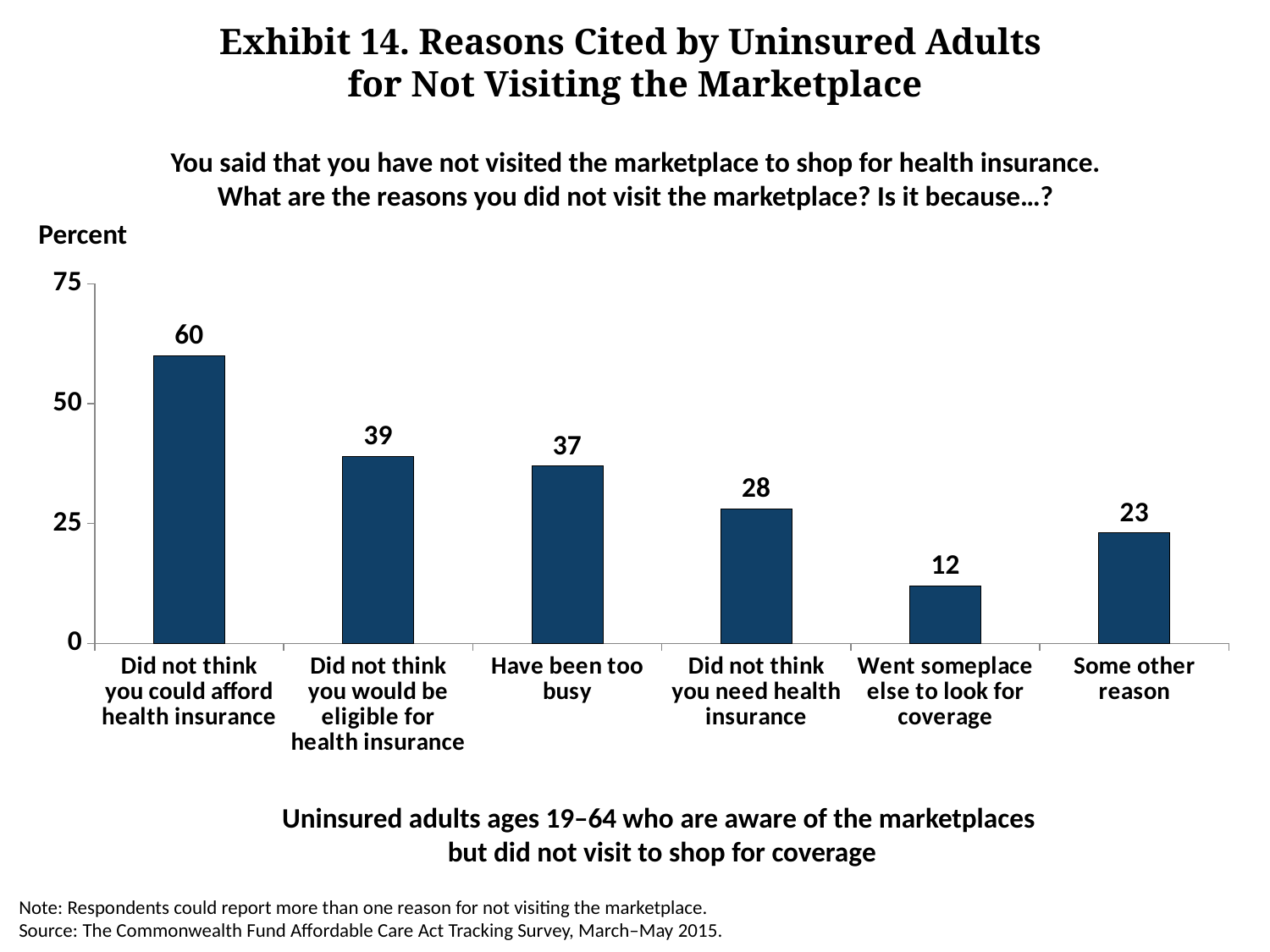
What is the difference between 'Did not think you could afford health insurance' and 'Did not think you would be eligible for health insurance'? 21 Which reason has the highest value? Did not think you could afford health insurance What is the value for 'Have been too busy'? 37 What percent cited 'Went someplace else to look for coverage'? 12 Which is larger: 'Did not think you would be eligible for health insurance' or 'Have been too busy'? Did not think you would be eligible for health insurance What is the value for 'Some other reason'? 23 How many reasons (categories) are shown in the chart? 6 What is the difference between 'Did not think you need health insurance' and 'Some other reason'? 5 What is the label on the vertical axis of the chart? Percent What type of chart is shown on the slide? Bar chart Which reason has the lowest value? Went someplace else to look for coverage What percent of uninsured adults said they did not think they could afford health insurance? 60